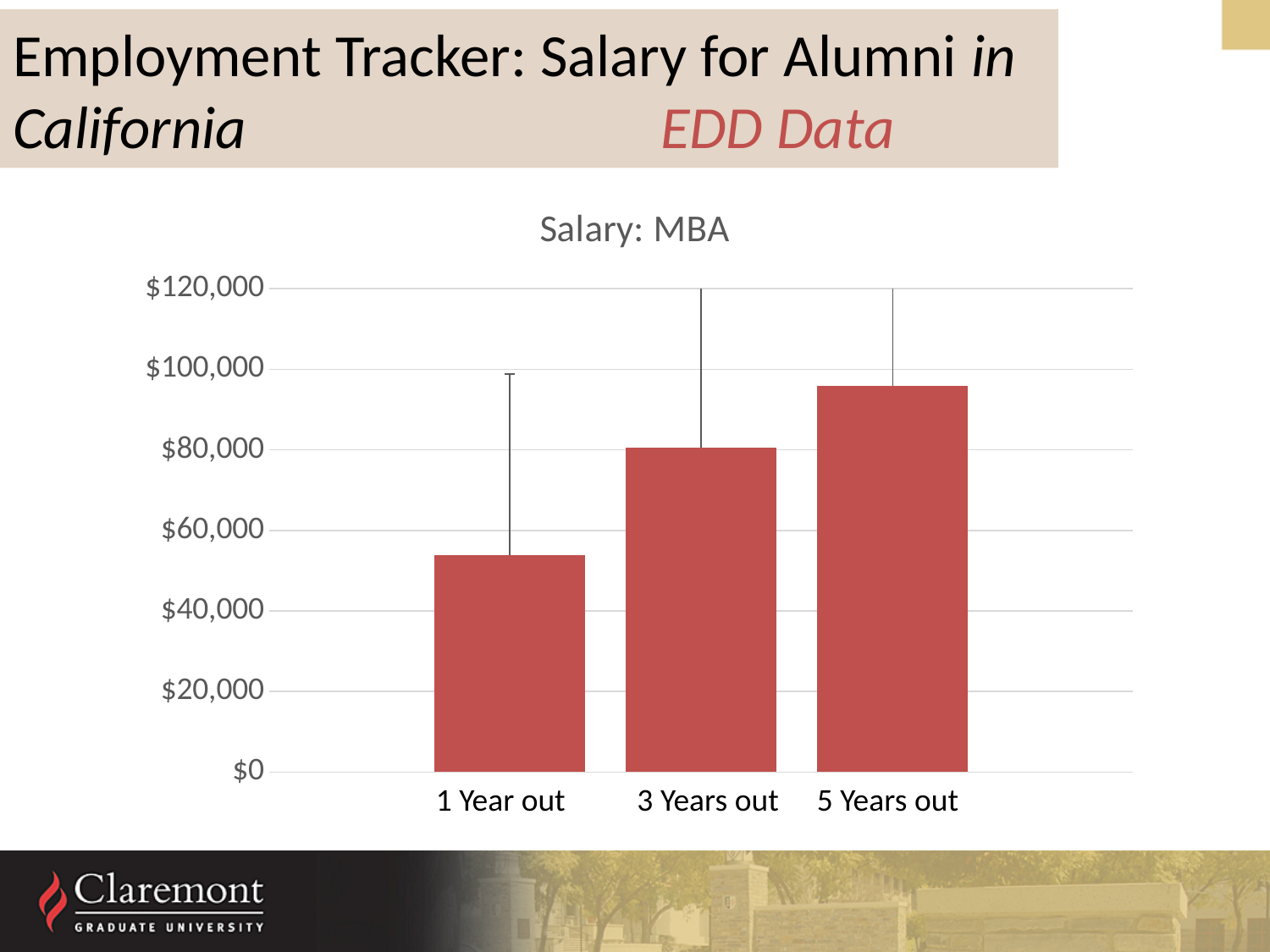
What is the title of the chart? Salary: MBA Is the salary for 1 Year out greater or less than $60,000? less Is the salary for 3 Years out greater or less than $100,000? less How many categories are shown on the x axis of the chart? 3 Which category has the highest salary in the chart? 5 Years out Is the salary for 5 Years out greater or less than $80,000? greater Which is larger, the salary for 1 Year out or for 3 Years out? 3 Years out Do the salary values rise or fall from 1 Year out to 5 Years out? rise What is the highest value labelled on the y axis of the chart? $120,000 Which category has the lowest salary in the chart? 1 Year out What kind of chart is shown on the slide? Bar chart